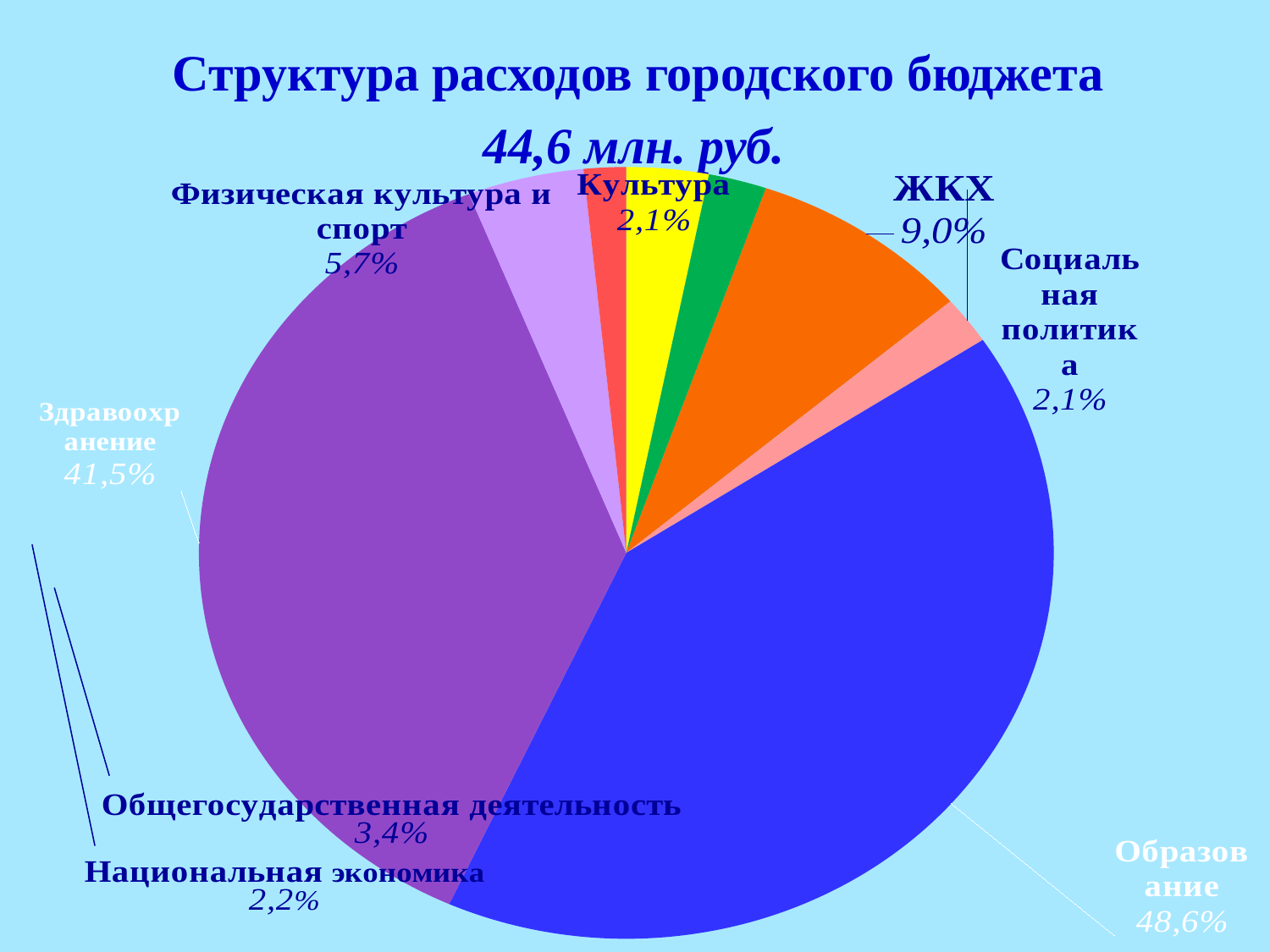
What percentage is shown for Физическая культура и спорт? 5,7% What share of the city budget expenditure goes to Образование? 48,6% How many categories are shown in the pie chart? 8 What share of the city budget expenditure goes to Здравоохранение? 41,5% What is the title of the chart? Структура расходов городского бюджета 44,6 млн. руб. What percentage is shown for ЖКХ? 9,0% Which category has the largest share of the budget expenditure? Образование What percentage is shown for Общегосударственная деятельность? 3,4% What type of chart is shown on the slide? pie chart What percentage is shown for Национальная экономика? 2,2% What is the difference in percentage points between Образование and Здравоохранение? 7,1 Which is larger, the share for ЖКХ or the share for Физическая культура и спорт? ЖКХ